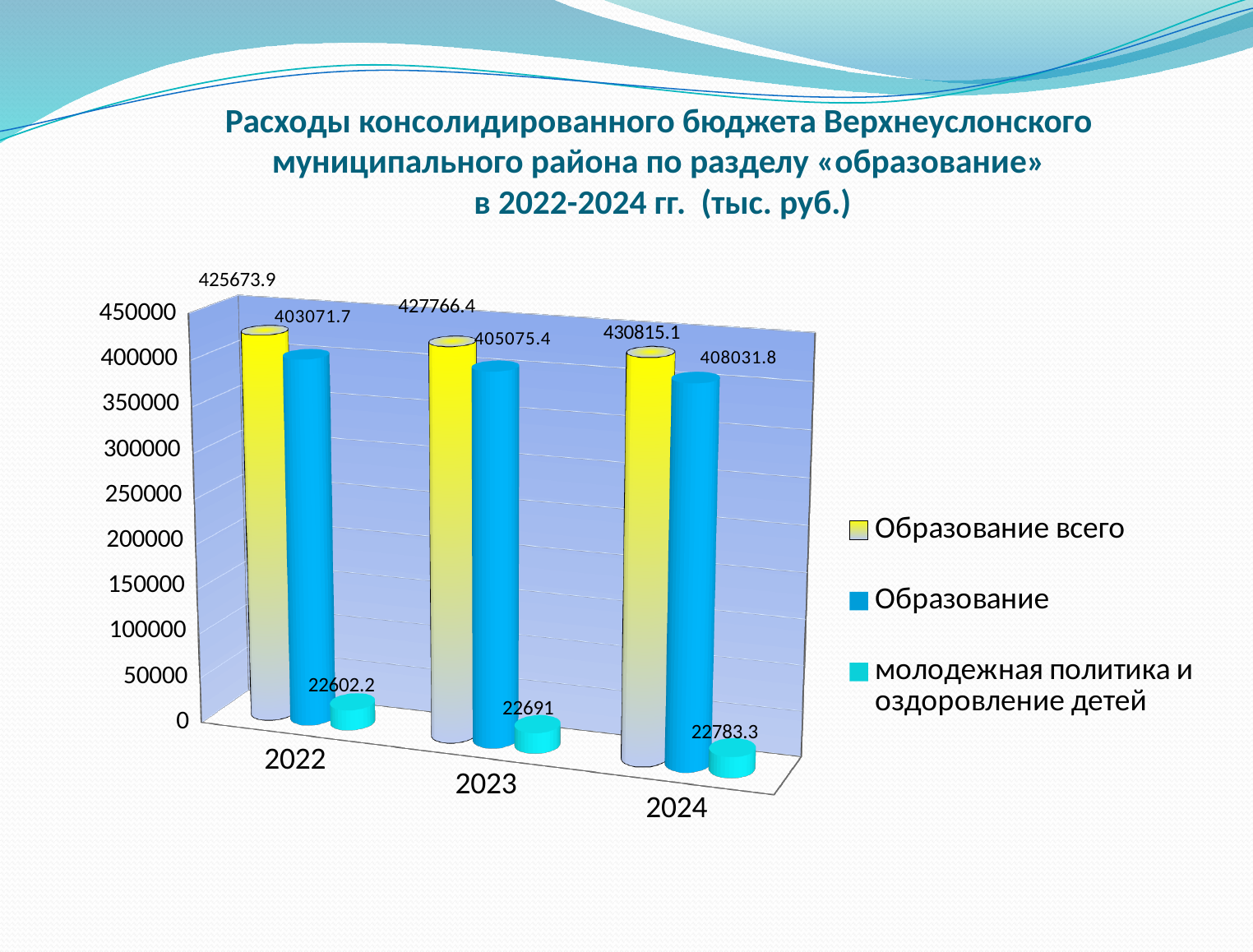
Which is larger in 2023: the value for "Образование" or the value for "молодежная политика и оздоровление детей"? Образование What is the value for "молодежная политика и оздоровление детей" in 2023? 22691 What is the difference between the "Образование" values for 2024 and 2022? 4960.1 In which year is the value for "молодежная политика и оздоровление детей" the lowest? 2022 What is the difference between the "Образование всего" values for 2024 and 2022? 5141.2 What is the value for "Образование" in 2024? 408031.8 What is the value for "Образование всего" in 2022? 425673.9 In which year is the value for "Образование всего" the highest? 2024 Is the value for "Образование" in 2022 greater or less than 400000? greater How many years are shown on the x axis? 3 How many series does the legend list? 3 Do the values for "Образование всего" rise or fall from 2022 to 2024? rise